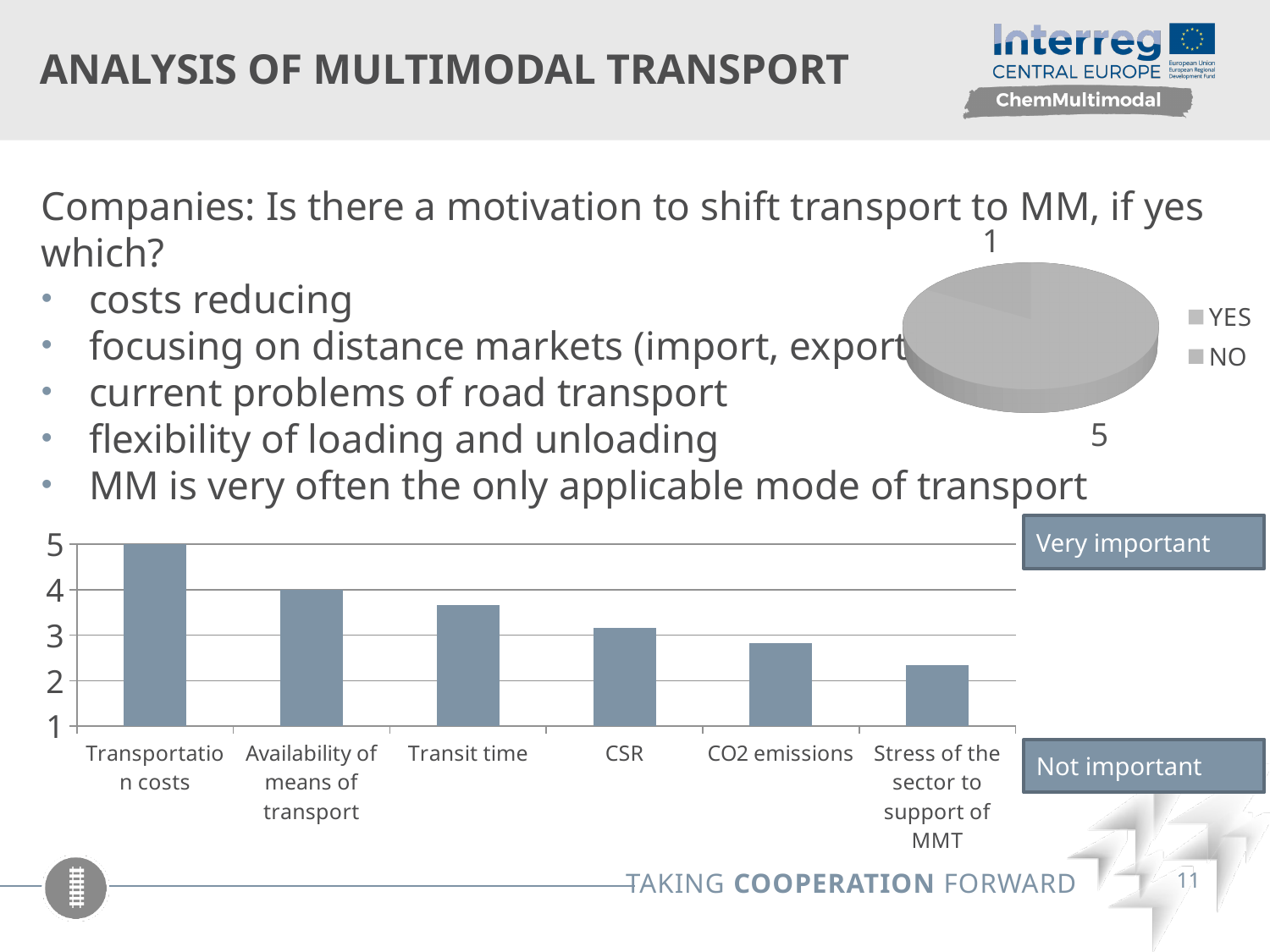
In the bar chart at the bottom of the slide, is the value for Transit time greater or less than 3? greater How many categories are shown in the bar chart at the bottom of the slide? 6 In the bar chart at the bottom of the slide, which category has the highest value? Transportation costs In the bar chart at the bottom of the slide, what is the difference between the values for Transportation costs and Availability of means of transport? 1 How many entries does the legend of the pie chart on the right of the slide list? 2 In the bar chart at the bottom of the slide, is the value for Stress of the sector to support of MMT greater or less than 3? less In the bar chart at the bottom of the slide, which category has the lowest value? Stress of the sector to support of MMT In the bar chart at the bottom of the slide, what is the value for Availability of means of transport? 4 What kind of chart is the chart at the bottom of the slide? bar chart Do the values in the bar chart at the bottom of the slide rise or fall from left to right? fall In the bar chart at the bottom of the slide, what is the value for Transportation costs? 5 In the bar chart at the bottom of the slide, which is larger: the value for Transit time or the value for CO2 emissions? Transit time